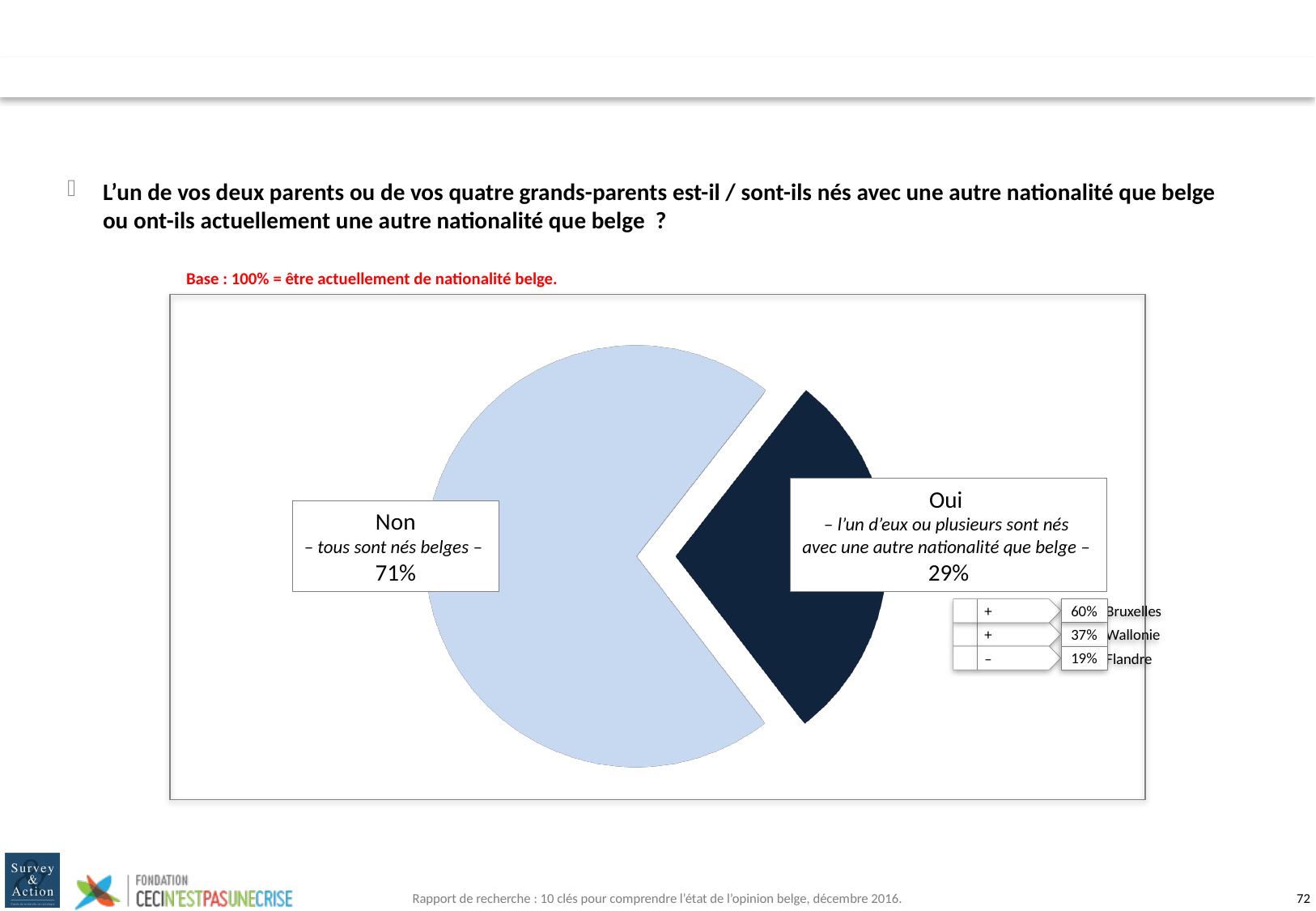
Which slice of the pie is larger, "Non" or "Oui"? Non What colour is the "Oui" slice of the pie? dark navy blue What percentage of respondents answered "Non" (all born Belgian)? 71% What is the "Oui" percentage for Bruxelles shown in the breakdown? 60% How many slices does the pie chart have? 2 What is the difference in percentage points between the "Non" and "Oui" slices? 42% What percentage of respondents answered "Oui" (one or more born with another nationality)? 29% What kind of chart is shown on the slide? pie chart What is the "Oui" percentage for Flandre shown in the breakdown? 19% What is the "Oui" percentage for Wallonie shown in the breakdown? 37% Among the regional breakdown (Bruxelles, Wallonie, Flandre), which region has the highest "Oui" percentage? Bruxelles Among the regional breakdown (Bruxelles, Wallonie, Flandre), which region has the lowest "Oui" percentage? Flandre